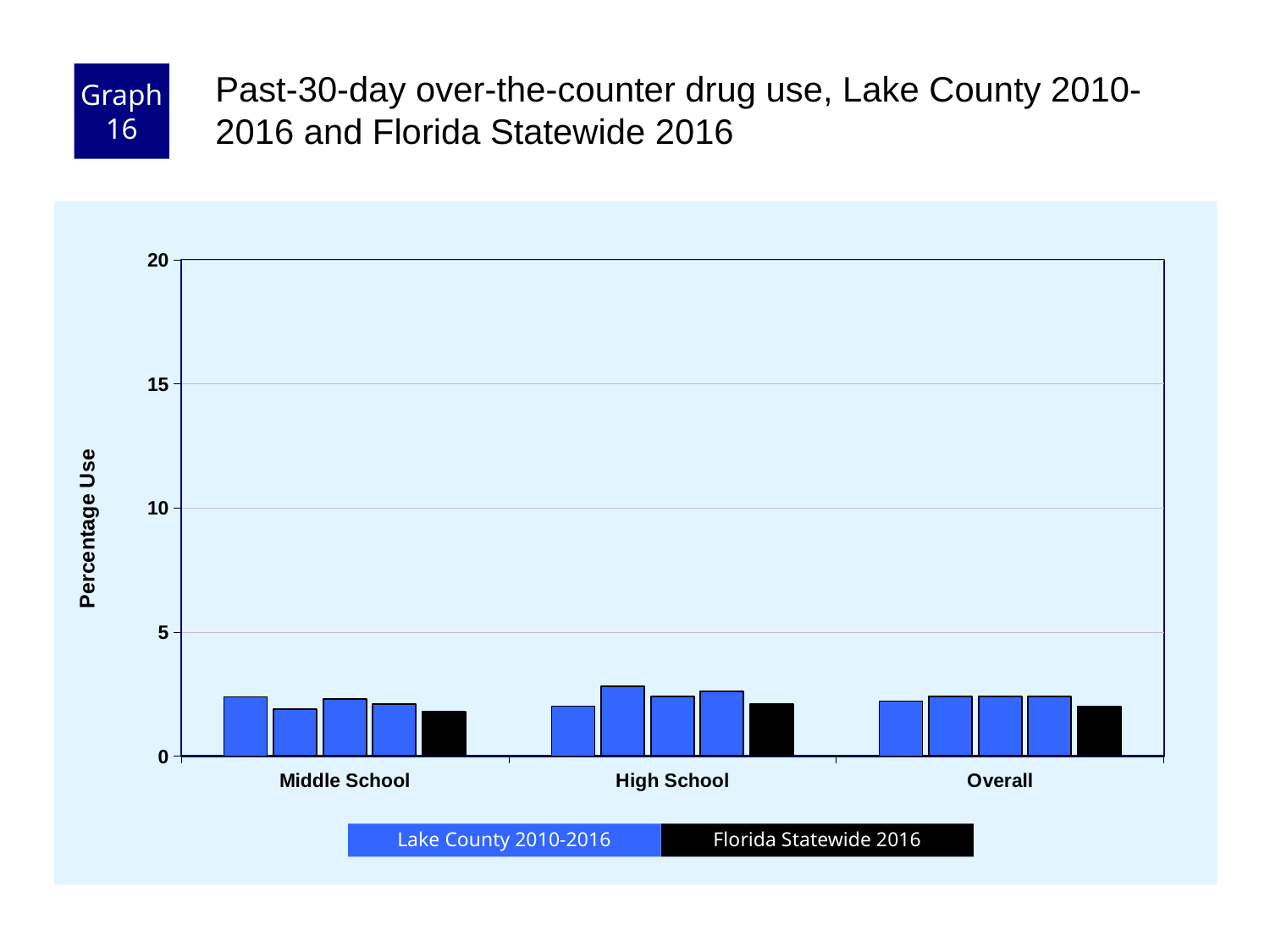
How many series does the legend list? 2 What is the title of the chart? Past-30-day over-the-counter drug use, Lake County 2010-2016 and Florida Statewide 2016 What is the label on the y axis? Percentage Use How many categories are shown on the x axis? 3 Is the value for Florida Statewide 2016 in the High School category greater or less than 5? less Is the value for Florida Statewide 2016 in the Middle School category greater or less than 5? less What kind of chart is shown on the slide? bar chart Are any of the bars in the High School category greater than 10? No What is the highest value shown on the y axis? 20